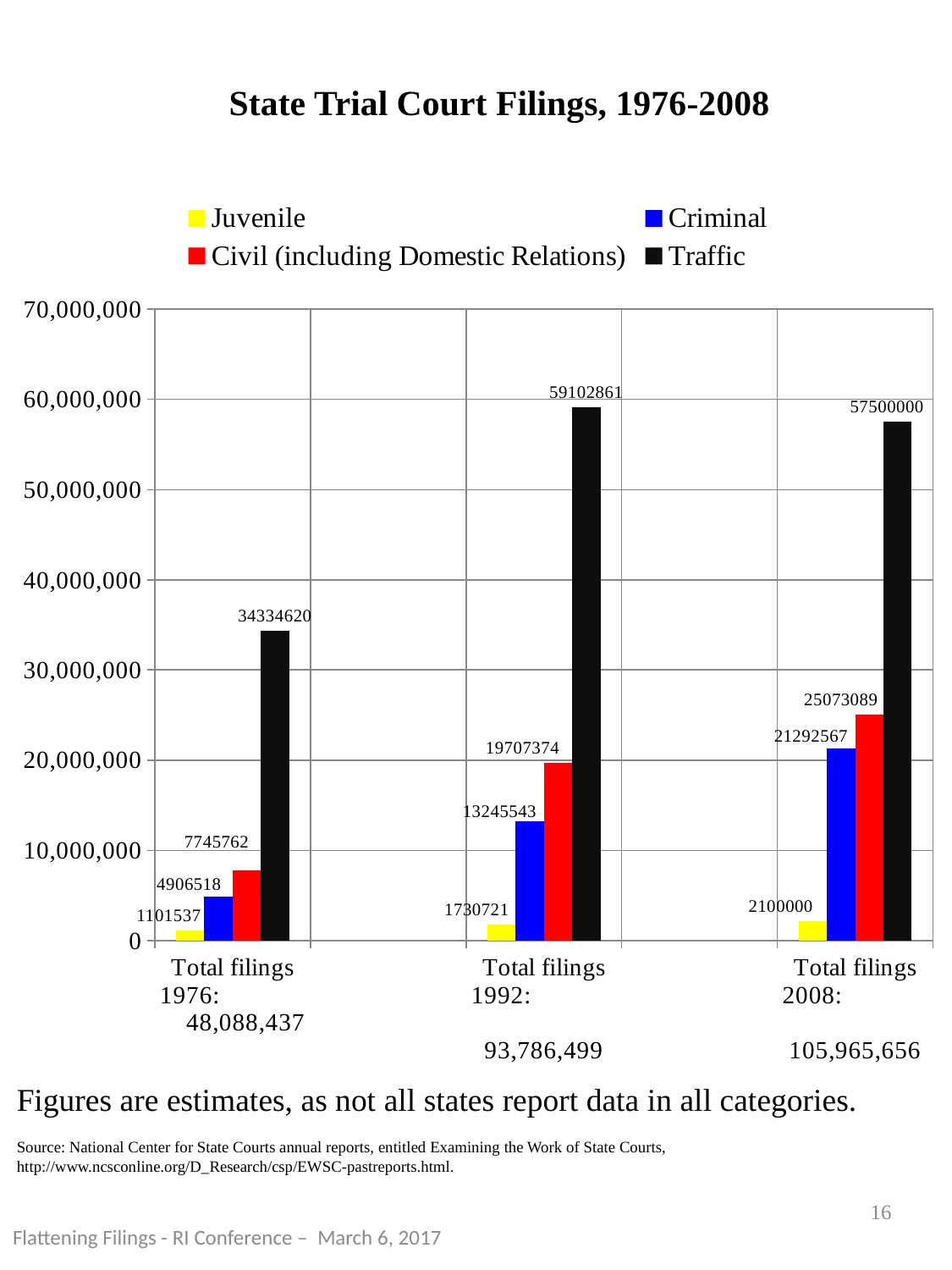
What is the value for Traffic in the Total filings 1992 category? 59102861 How many series does the legend list? 4 What is the value for Criminal in the Total filings 1992 category? 13245543 What is the value for Civil (including Domestic Relations) in the Total filings 2008 category? 25073089 Which series has the lowest value in the Total filings 1976 category? Juvenile Which series has the highest value in the Total filings 2008 category? Traffic Do the Criminal values rise or fall from 1976 to 2008? Rise Which is larger, the Traffic value for 1992 or the Traffic value for 2008? Traffic value for 1992 What is the difference between the Traffic value for 1992 and the Traffic value for 2008? 1602861 What kind of chart is shown on the slide? Bar chart What is the difference between the Civil (including Domestic Relations) value and the Criminal value in the Total filings 2008 category? 3780522 What is the value for Juvenile in the Total filings 1976 category? 1101537